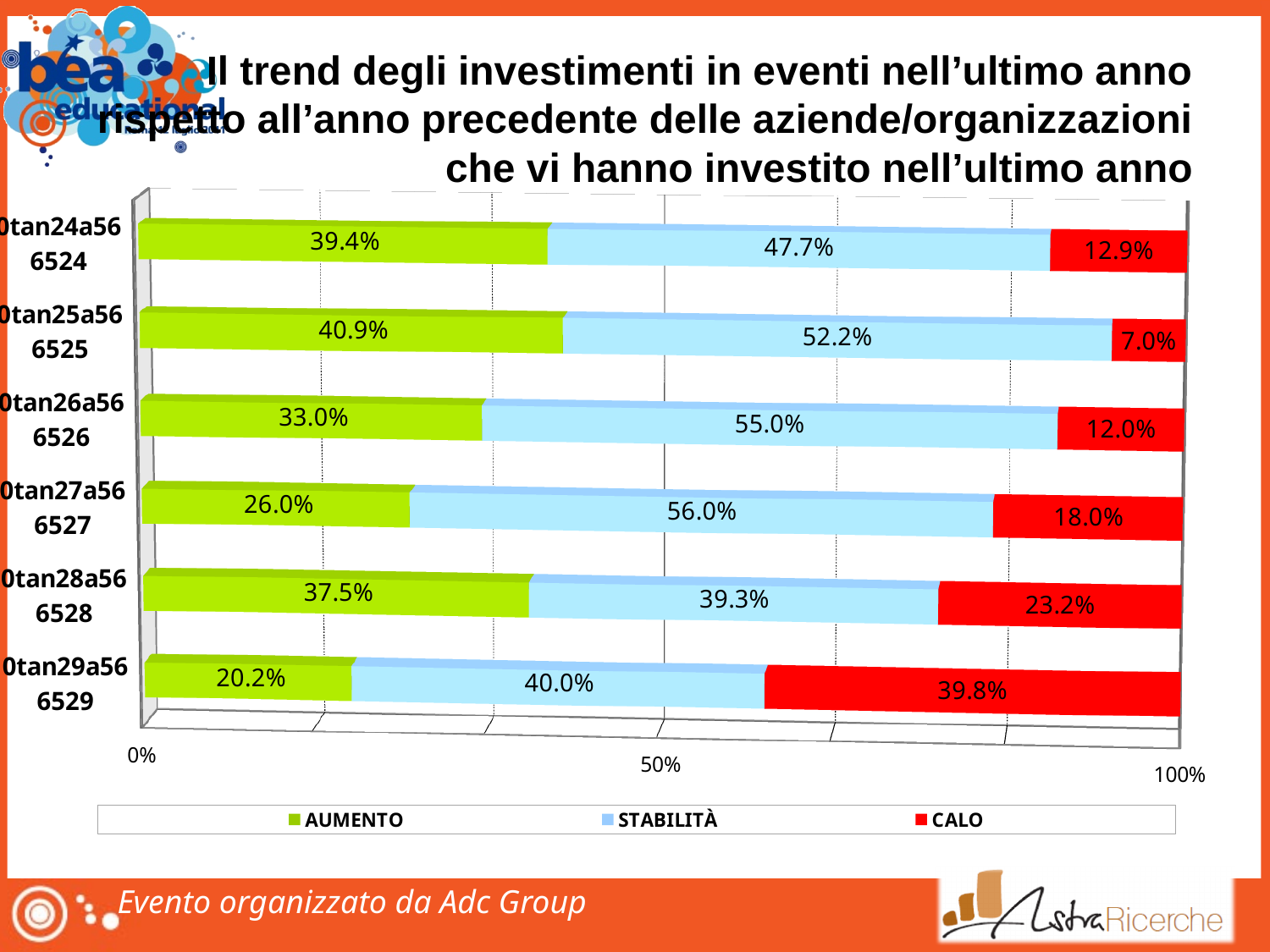
What colour represents the CALO series in the chart? Red How many bars (categories) are plotted in the chart? 6 What type of chart is shown on the slide? Stacked bar chart In the fourth bar from the top (label ending in 6527), what is the difference between the STABILITÀ value and the AUMENTO value? 30.0 percentage points What is the STABILITÀ value for the top bar (label ending in 6524)? 47.7% What is the AUMENTO value for the fifth bar from the top (label ending in 6528)? 37.5% How many series does the legend list? 3 What is the CALO value for the bottom bar (label ending in 6529)? 39.8% What is the total of the three segments in the top bar (label ending in 6524)? 100.0% In the fifth bar from the top (label ending in 6528), which is larger: AUMENTO or CALO? AUMENTO Which bar has the lowest CALO value? The second bar from the top (label ending in 6525), 7.0% Which bar has the highest AUMENTO value? The second bar from the top (label ending in 6525), 40.9%